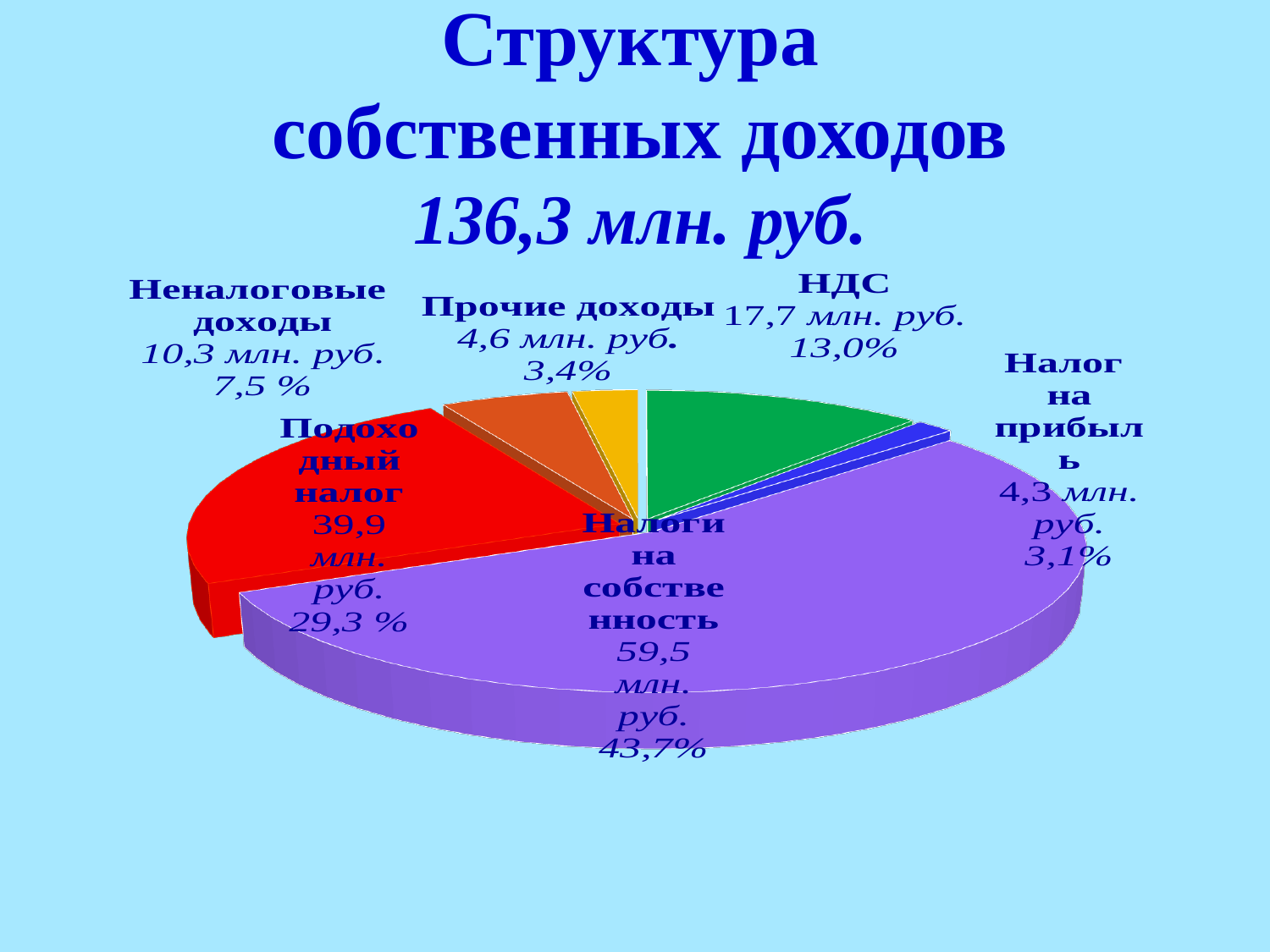
How many slices does the pie chart have? 6 Which category has the smallest slice of the pie? Налог на прибыль What share of the pie does Неналоговые доходы represent? 7,5 % What kind of chart is shown on the slide? pie chart What share of the pie does НДС represent? 13,0% Which is larger, Прочие доходы or Неналоговые доходы? Неналоговые доходы What colour is the slice for Подоходный налог? red What is the value for Налоги на собственность? 59,5 млн. руб. What is the value for Подоходный налог? 39,9 млн. руб. Which category has the largest slice of the pie? Налоги на собственность What is the difference in млн. руб. between Налоги на собственность and Подоходный налог? 19,6 млн. руб. What total amount is stated in the chart title? 136,3 млн. руб.